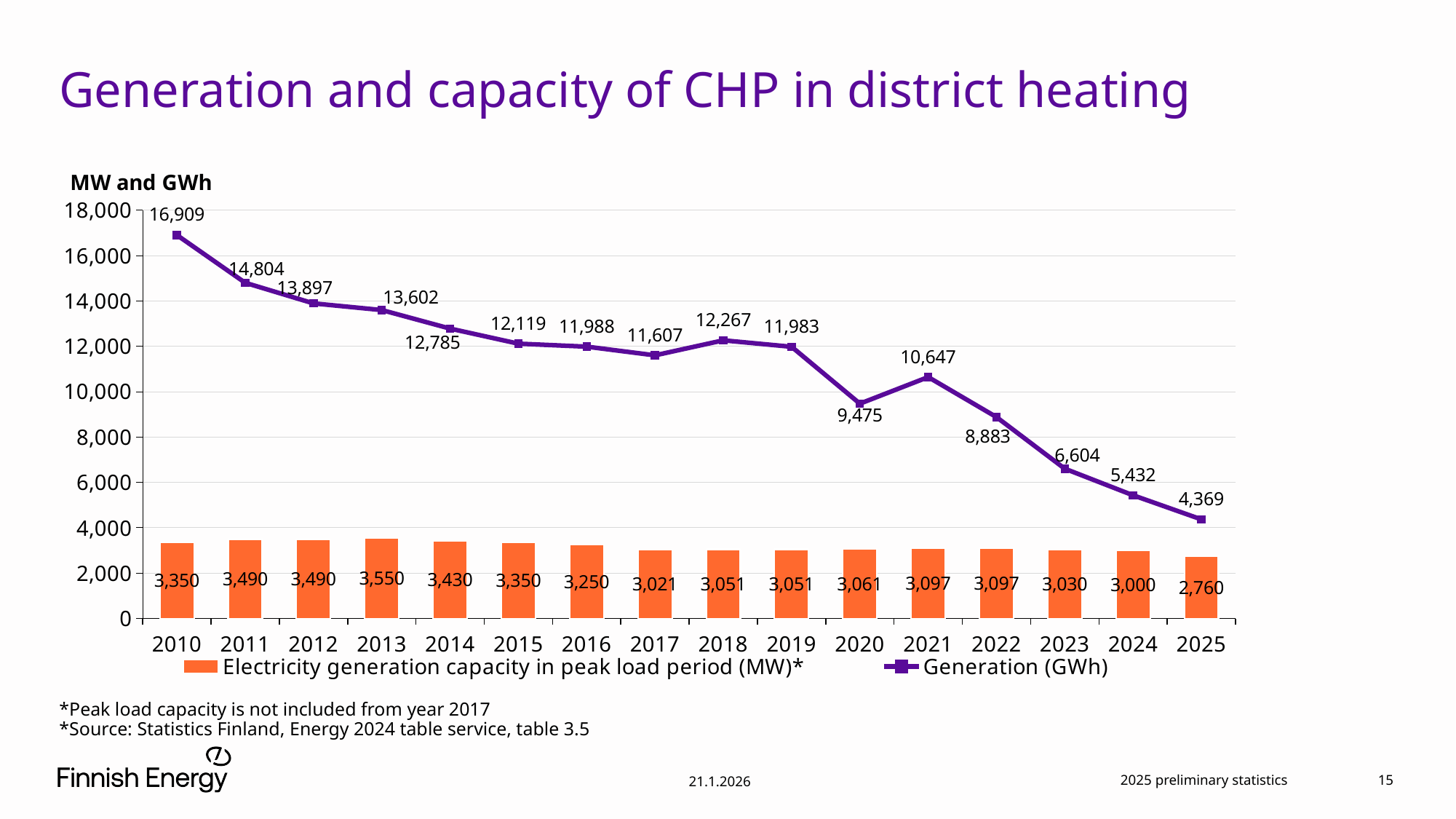
What is the difference between the capacity (MW) in 2024 and in 2025? 240 Which year has the larger Generation (GWh) value, 2018 or 2019? 2018 What kind of chart is shown on the slide? Combination bar and line chart How many series does the legend list? 2 What is the difference between Generation (GWh) in 2010 and in 2025? 12,540 In which year is the Electricity generation capacity in peak load period (MW) lowest? 2025 What is the Generation (GWh) value for 2021? 10,647 In which year is Generation (GWh) highest? 2010 What is the Electricity generation capacity in peak load period (MW) for 2013? 3,550 How many years are shown on the x axis? 16 In which year is the Electricity generation capacity in peak load period (MW) highest? 2013 What is the Generation (GWh) value for 2020? 9,475